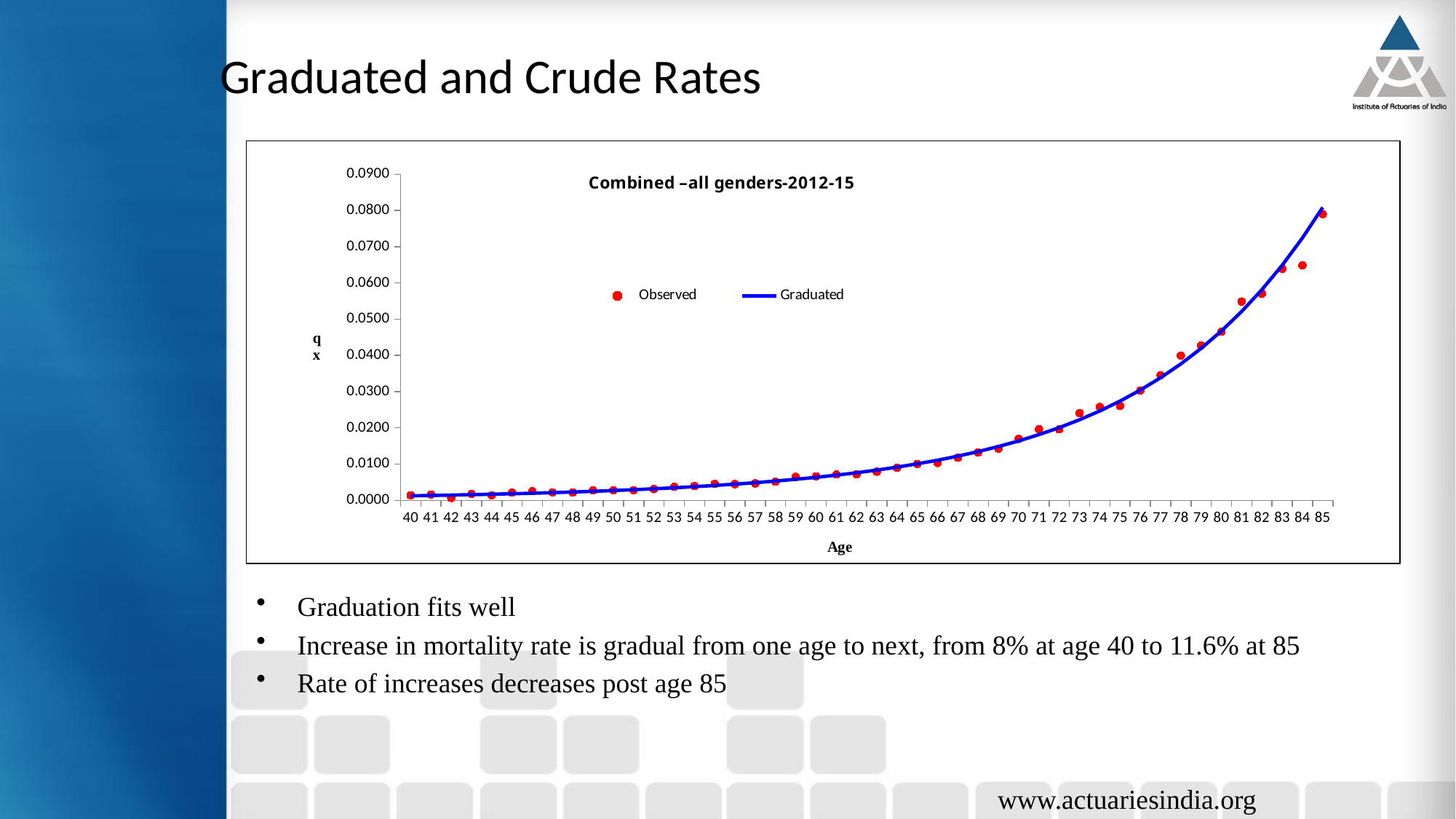
Is the observed value at age 80 greater or less than 0.0400? greater What is the title of the chart? Combined –all genders-2012-15 What kind of chart is shown on the slide? Line chart (observed points with a graduated line) Is the observed value at age 85 greater or less than 0.0700? greater What are the two series named in the chart legend? Observed and Graduated Do the observed mortality rates rise or fall as age increases from 40 to 85? Rise How many series does the chart legend list? 2 Is the observed value at age 60 greater or less than 0.0100? less How many ages are plotted along the x axis of the chart? 46 At which age is the observed value highest? 85 Which has the larger observed value, age 84 or age 85? Age 85